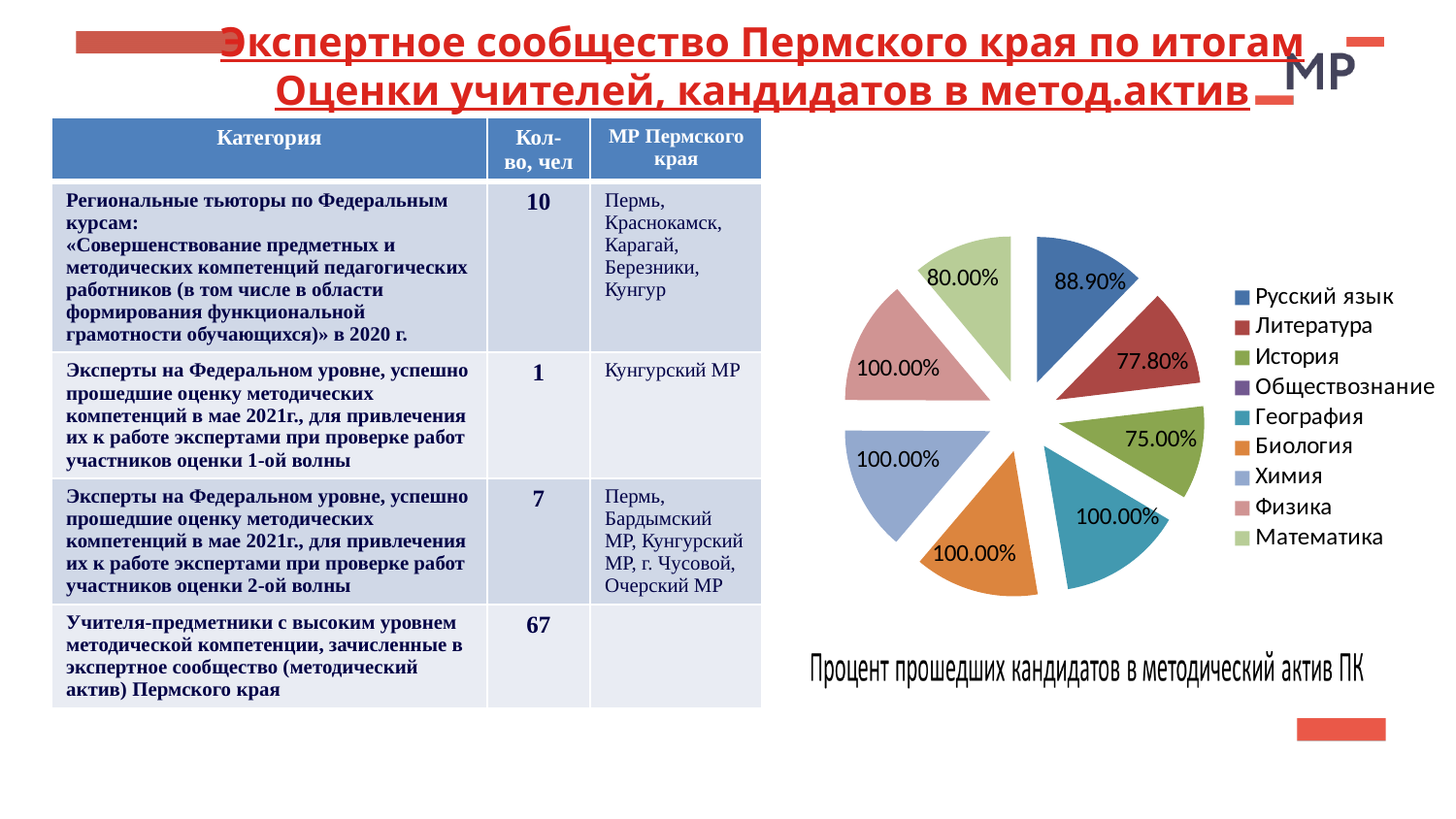
What kind of chart is shown on the slide? pie chart What is the difference between the values for Русский язык and Литература in the pie chart? 11.10% What is the caption under the pie chart? Процент прошедших кандидатов в методический актив ПК What is the value shown for Литература in the pie chart? 77.80% Which is larger in the pie chart, the value for Русский язык or the value for Литература? Русский язык Which is larger in the pie chart, the value for Математика or the value for История? Математика What is the value shown for Биология in the pie chart? 100.00% What is the value shown for История in the pie chart? 75.00% What is the value shown for Русский язык in the pie chart? 88.90% What is the value shown for Математика in the pie chart? 80.00% How many entries does the legend of the pie chart list? 9